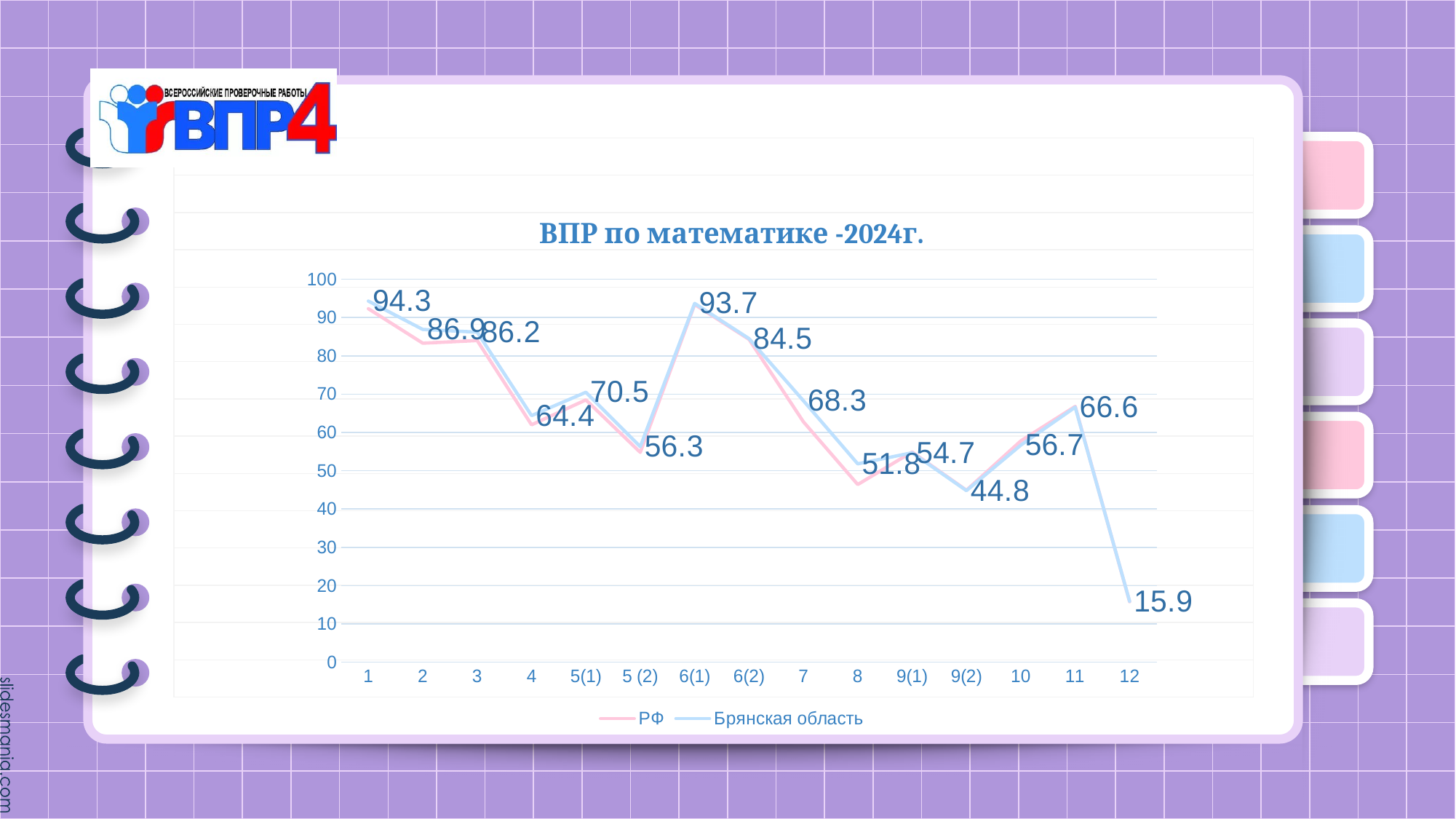
What is the value for Брянская область at category 6(1)? 93.7 For Брянская область, which is larger: the value at category 5(1) or at category 5(2)? 5(1) What type of chart is shown on the slide? Line chart Which category has the lowest value for Брянская область? 12 What is the value for Брянская область at category 1? 94.3 What is the value for Брянская область at category 12? 15.9 How many series does the legend list? 2 What is the value for Брянская область at category 9(2)? 44.8 How many categories are shown on the x axis? 15 Is the value for РФ at category 8 greater or less than 50? less Which category has the highest value for Брянская область? 1 What is the difference between the Брянская область values at category 11 and category 12? 50.7